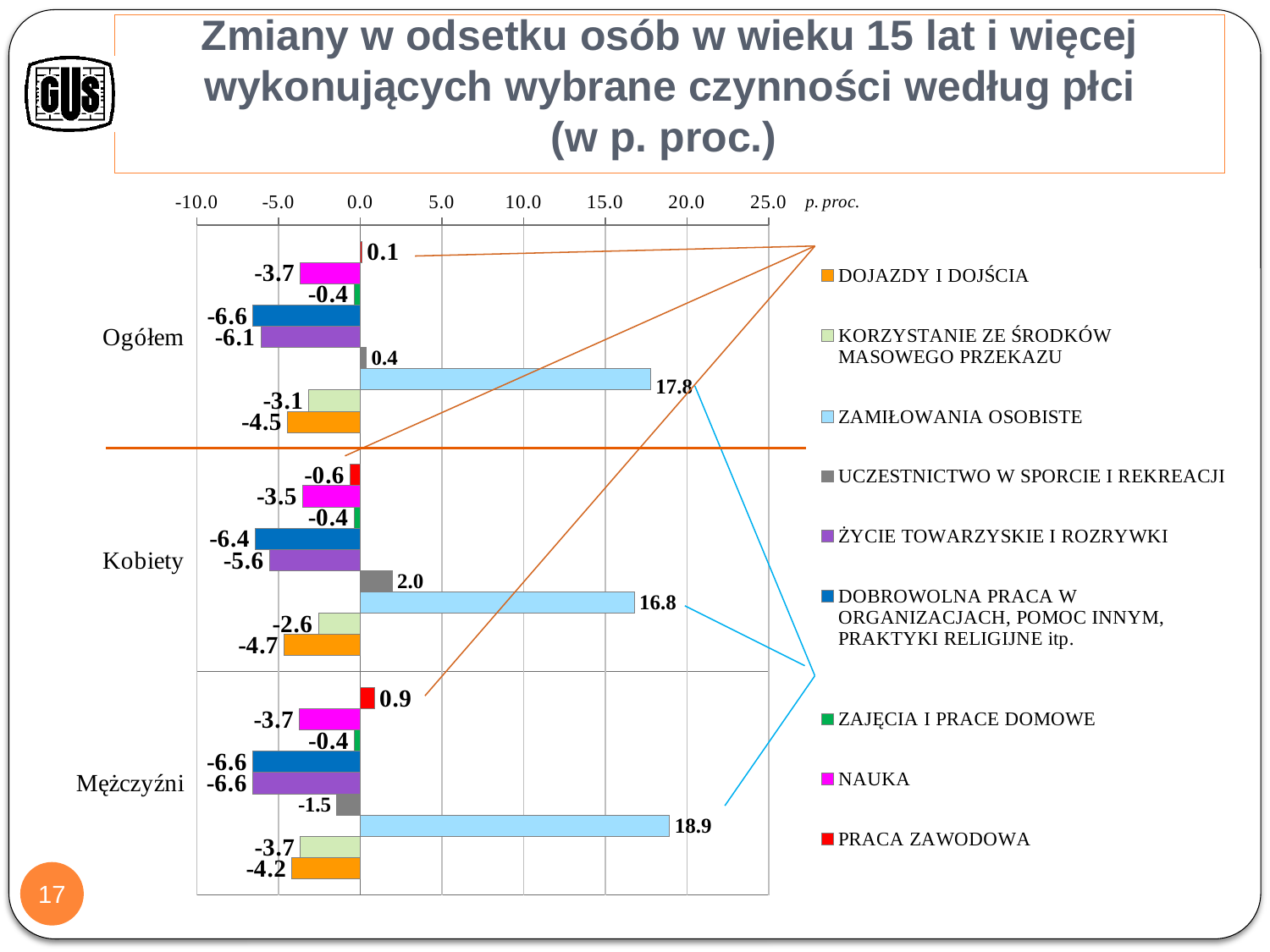
What is the value for ZAMIŁOWANIA OSOBISTE in the Mężczyźni group? 18.9 How many category groups (Ogółem, Kobiety, Mężczyźni) are shown on the y axis? 3 Which is larger: the value for ŻYCIE TOWARZYSKIE I ROZRYWKI in the Ogółem group or in the Kobiety group? Kobiety Which series has the lowest value in the Kobiety group? DOBROWOLNA PRACA W ORGANIZACJACH, POMOC INNYM, PRAKTYKI RELIGIJNE itp. What is the difference between the ZAMIŁOWANIA OSOBISTE values for Mężczyźni and Kobiety? 2.1 What type of chart is shown on the slide? bar chart What is the value for DOJAZDY I DOJŚCIA in the Kobiety group? -4.7 What unit is indicated at the end of the x axis? p. proc. What is the value for PRACA ZAWODOWA in the Ogółem group? 0.1 What is the value for UCZESTNICTWO W SPORCIE I REKREACJI in the Kobiety group? 2.0 How many series does the legend list? 9 Which group has the highest value for ZAMIŁOWANIA OSOBISTE? Mężczyźni